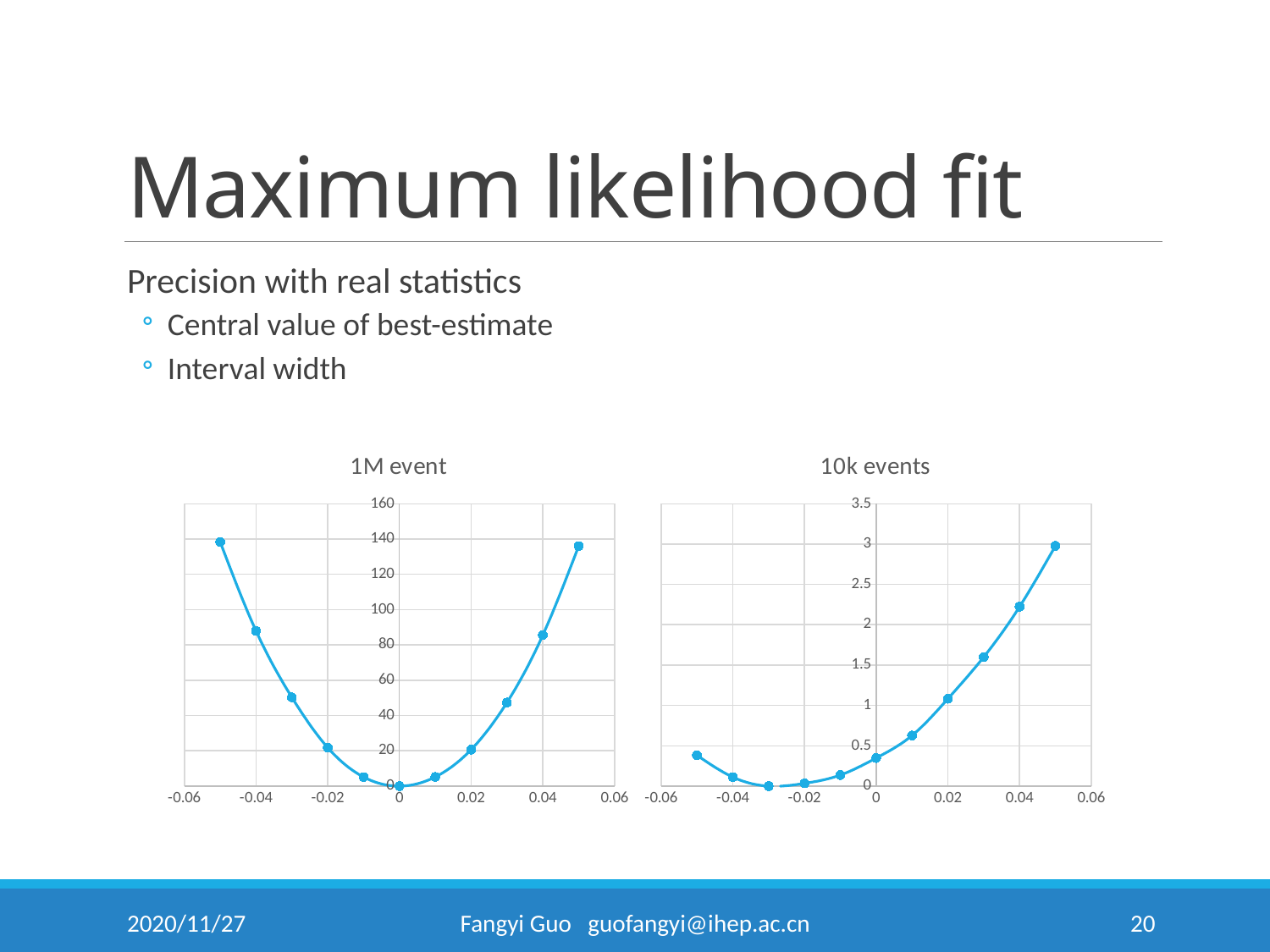
What kind of chart is the "1M event" chart? line chart In the "10k events" chart, which is larger: the value at x = 0.05 or the value at x = -0.05? x = 0.05 How many data points are plotted in the "10k events" chart? 11 In the "1M event" chart, is the value at x = -0.05 greater or less than 120? greater In the "10k events" chart, is the value at x = 0.05 greater or less than 2.5? greater In the "1M event" chart, what is the value at x = 0? 0 In the "10k events" chart, at which x value is the plotted value highest? 0.05 What is the title of the chart on the right of the slide? 10k events In the "10k events" chart, do the values rise or fall from x = 0 to x = 0.05? rise In the "10k events" chart, is the value at x = -0.05 greater or less than 0.5? less In the "1M event" chart, at which x value is the plotted value lowest? 0